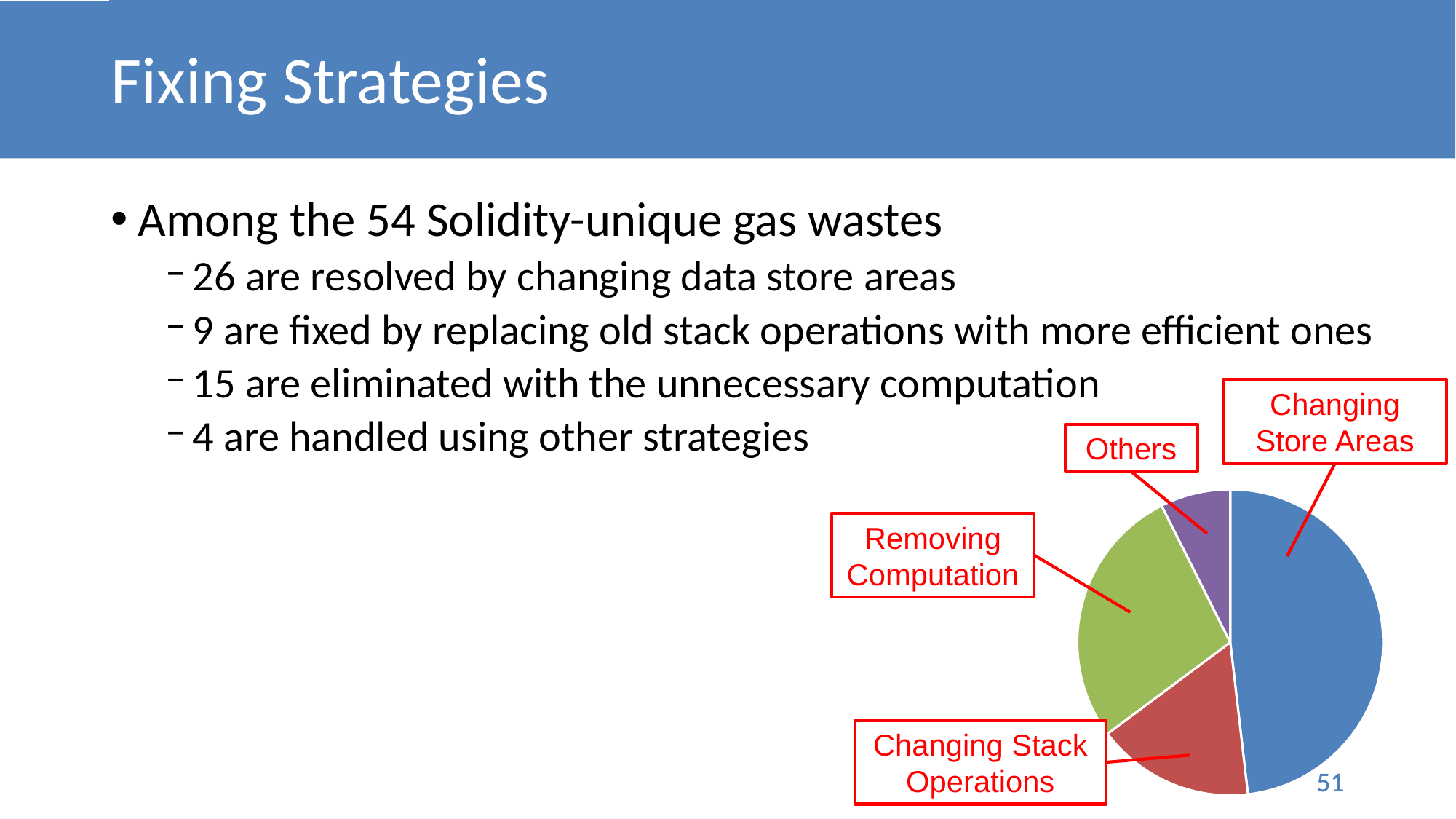
What is the title of the slide containing the pie chart? Fixing Strategies Which slice is larger, Removing Computation or Changing Stack Operations? Removing Computation According to the slide, how many gas wastes are resolved by changing data store areas? 26 What colour is the Changing Store Areas slice of the pie chart? blue How many slices does the pie chart have? 4 Which slice of the pie chart is the largest? Changing Store Areas How many more gas wastes are resolved by changing data store areas than by replacing old stack operations? 17 What kind of chart is shown on the slide? pie chart According to the slide, how many gas wastes are handled using other strategies? 4 Which slice of the pie chart is the smallest? Others Which slice is larger, Changing Store Areas or Removing Computation? Changing Store Areas According to the slide, how many gas wastes are eliminated with the unnecessary computation? 15